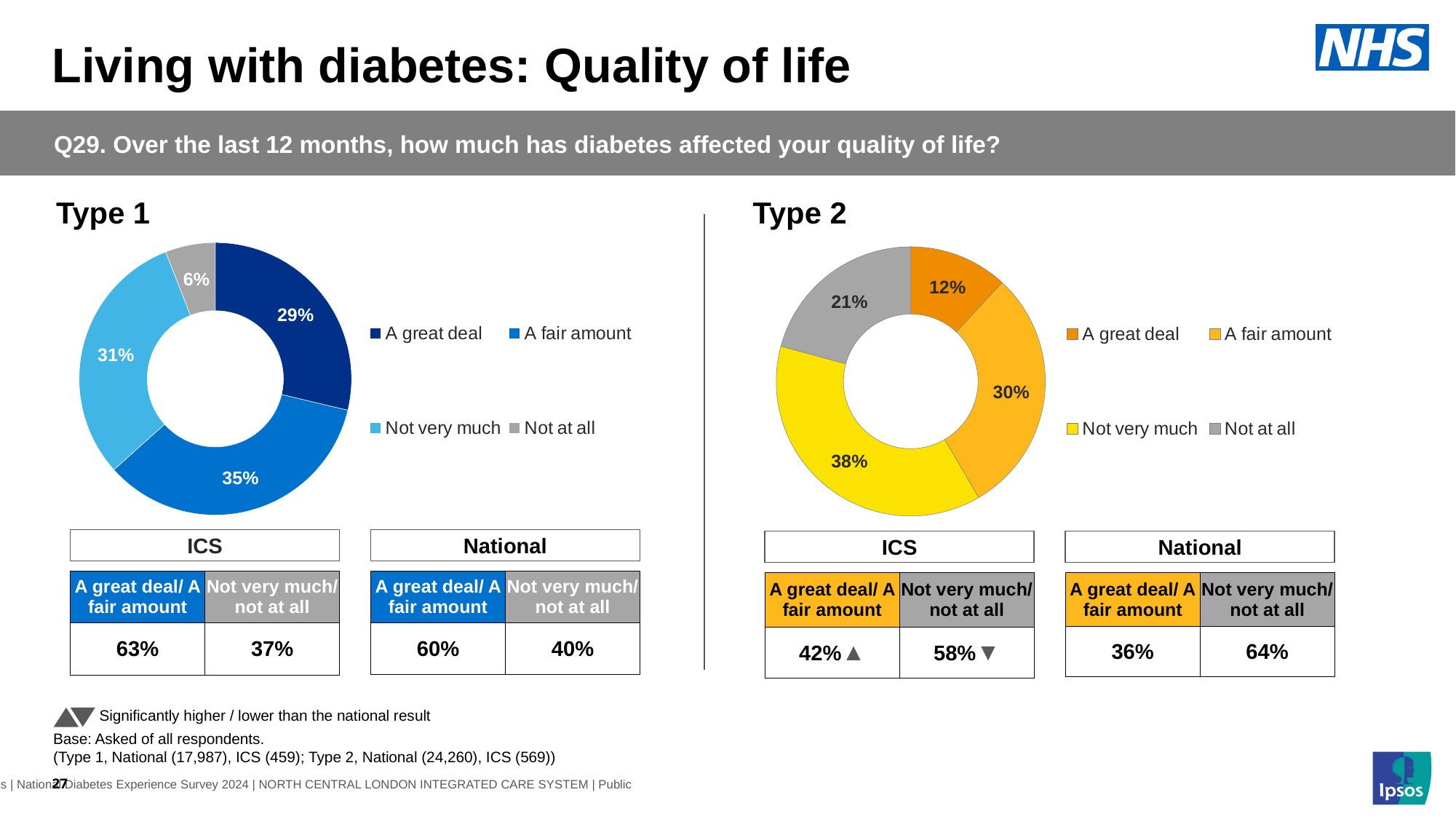
How many legend entries does the Type 2 chart list? 4 How many categories does the Type 1 chart show? 4 What kind of chart is used for Type 2? Doughnut chart In the Type 1 chart, which category has the largest share? A fair amount In the Type 1 chart, what is the difference in percentage points between 'Not very much' and 'Not at all'? 25 In the Type 2 chart, what percentage of respondents said 'Not at all'? 21% In the Type 2 chart, what is the combined share of 'A great deal' and 'A fair amount'? 42% In the Type 1 chart, what is the combined share of 'Not very much' and 'Not at all'? 37% In the Type 2 chart, which category has the smallest share? A great deal In the Type 2 chart, which is larger: 'A fair amount' or 'Not very much'? Not very much In the Type 1 chart, what colour represents 'A great deal'? Dark blue In the Type 1 chart, what percentage of respondents said diabetes affected their quality of life 'A fair amount'? 35%